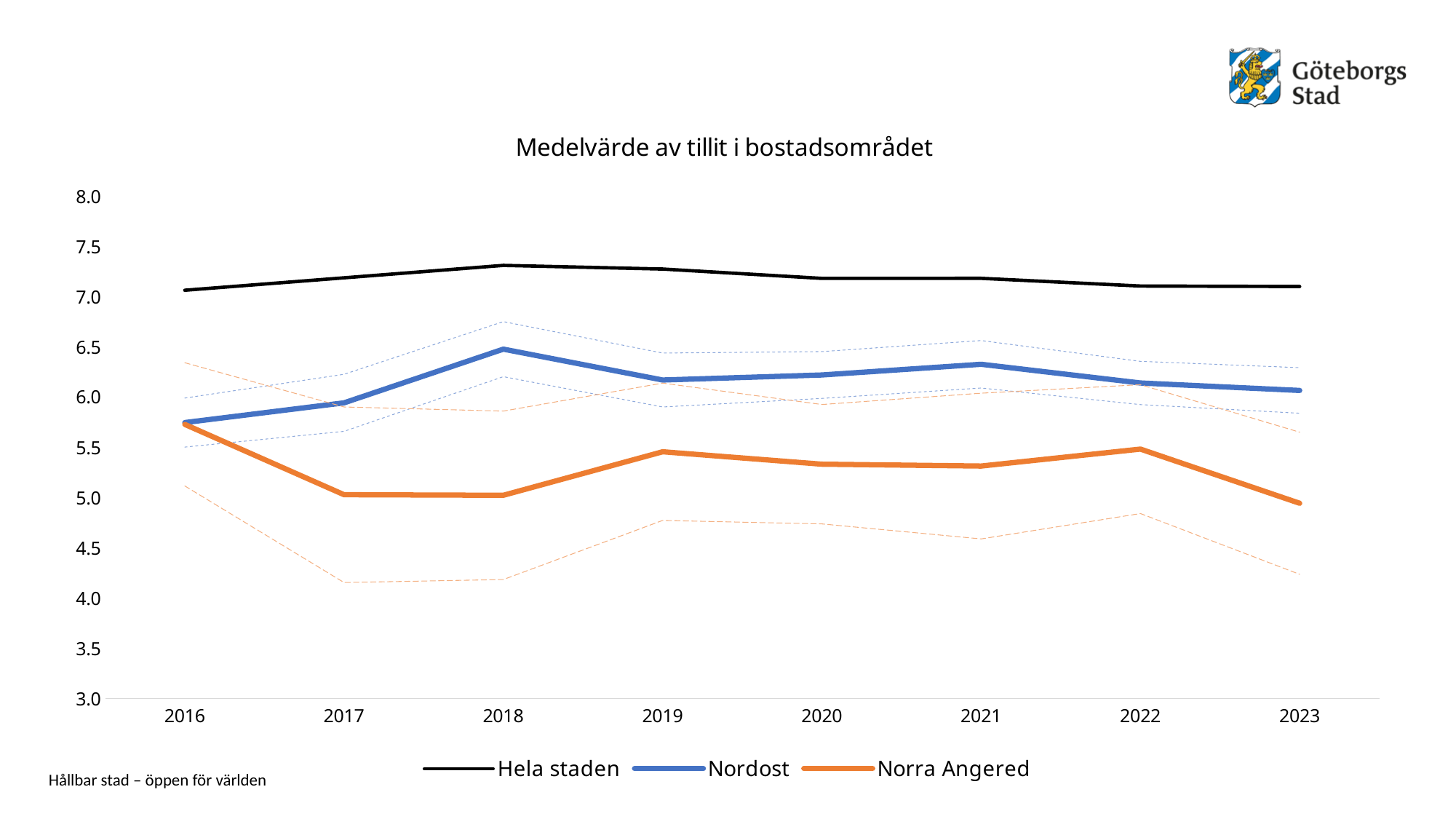
Is the value for Norra Angered in 2017 greater or less than 5.5? less How many years are shown on the x axis? 8 In which year does the Nordost line reach its highest value? 2018 Does the Norra Angered line rise or fall from 2022 to 2023? fall How many series does the legend list? 3 Which series has the higher value in 2020, Nordost or Norra Angered? Nordost Which series is plotted with the orange line? Norra Angered What kind of chart is shown on the slide? line chart Is the value for Hela staden in 2018 greater or less than 7.0? greater In which year does the Norra Angered line reach its highest value? 2016 In which year does the Nordost line have its lowest value? 2016 What is the title of the chart? Medelvärde av tillit i bostadsområdet